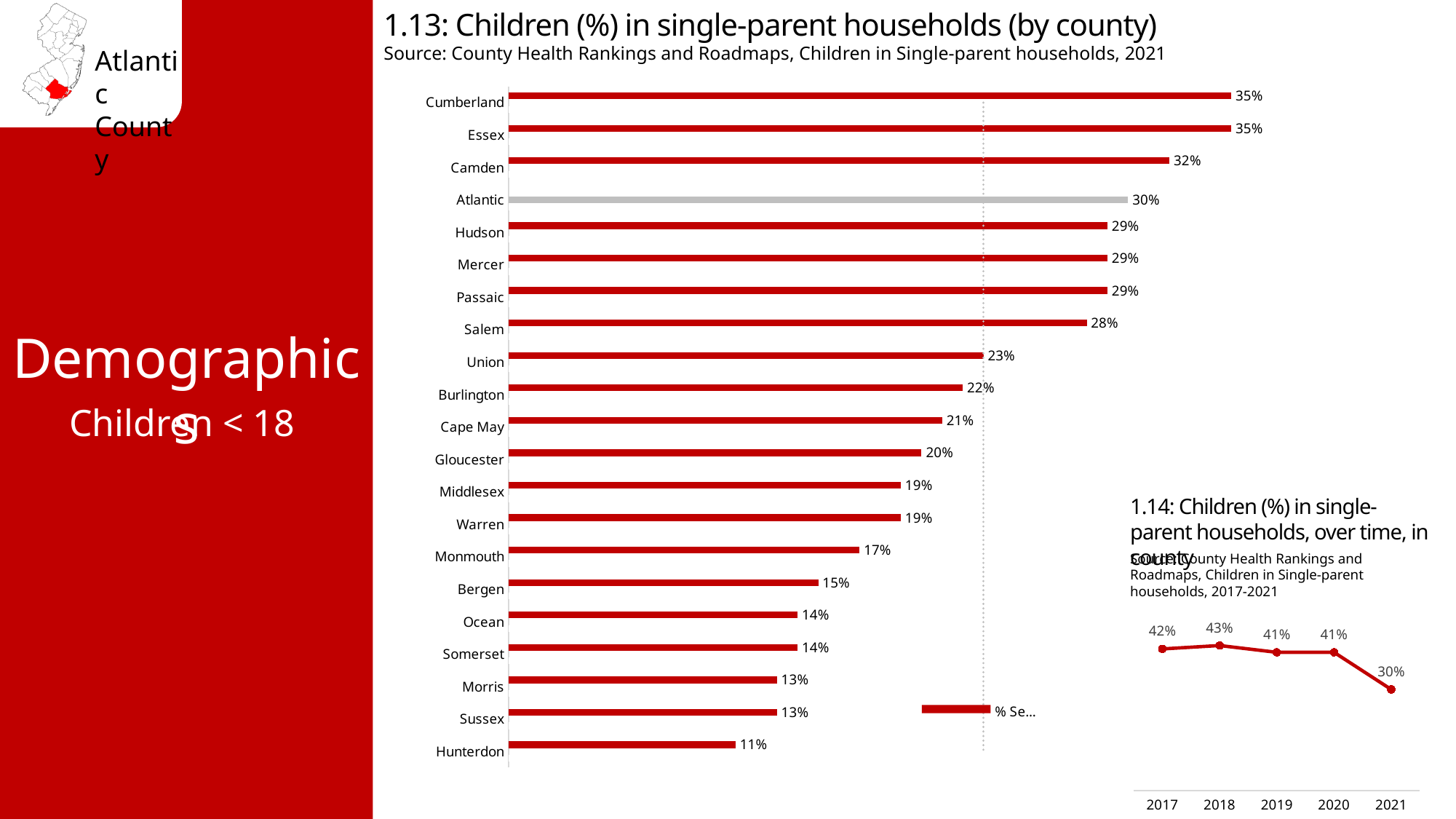
In chart 1.13 (by county), which is larger, Salem or Union? Salem What kind of chart is chart 1.13 (Children in single-parent households by county)? Bar chart In chart 1.13 (by county), how many counties are shown? 21 In chart 1.14 (over time, in county), what is the difference between 2020 and 2021? 11% In chart 1.14 (over time, in county), how many years are plotted? 5 In chart 1.14 (over time, in county), which year has the highest value? 2018 In chart 1.14 (over time, in county), what is the value for 2021? 30% In chart 1.13 (by county), what is the value for Camden? 32% In chart 1.13 (by county), what is the difference between Atlantic and Hunterdon? 19% In chart 1.13 (by county), which county has the lowest value? Hunterdon In chart 1.13 (Children in single-parent households by county), what is the value for Atlantic? 30% What kind of chart is chart 1.14 (Children in single-parent households over time)? Line chart